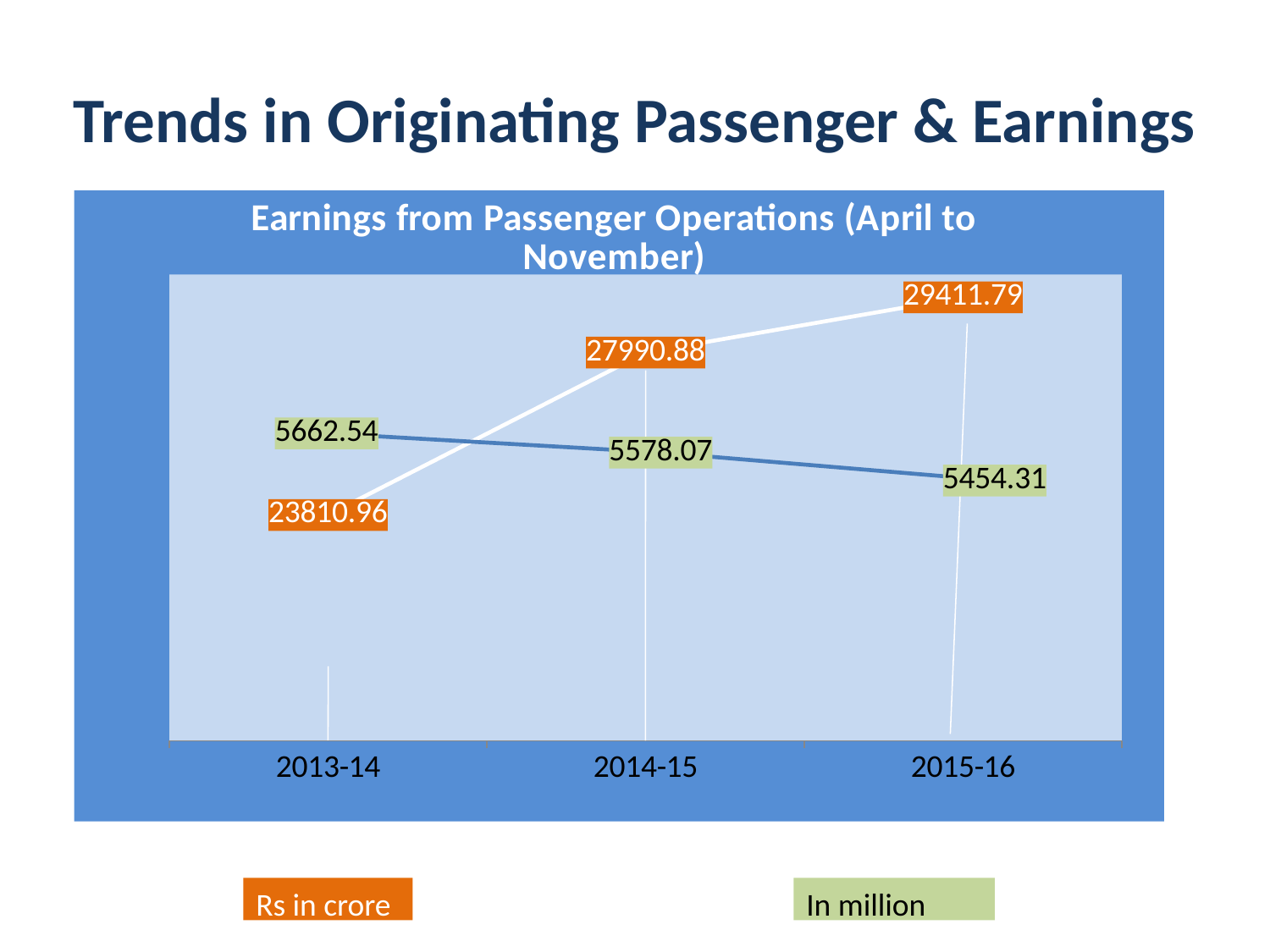
How many years are shown on the x axis of the chart? 3 In which year is the earnings value (Rs in crore) highest? 2015-16 What is the earnings value (Rs in crore) for 2013-14? 23810.96 Which is larger: the originating passengers value for 2013-14 or for 2015-16? 2013-14 What type of chart is shown on the slide? line chart What is the originating passengers value (in million) for 2015-16? 5454.31 What is the earnings value (Rs in crore) for 2015-16? 29411.79 Do the originating passengers values (in million) rise or fall from 2013-14 to 2015-16? fall What is the originating passengers value (in million) for 2014-15? 5578.07 What is the title of the chart? Earnings from Passenger Operations (April to November) What is the difference between the earnings values (Rs in crore) for 2014-15 and 2013-14? 4179.92 In which year is the originating passengers value (in million) lowest? 2015-16